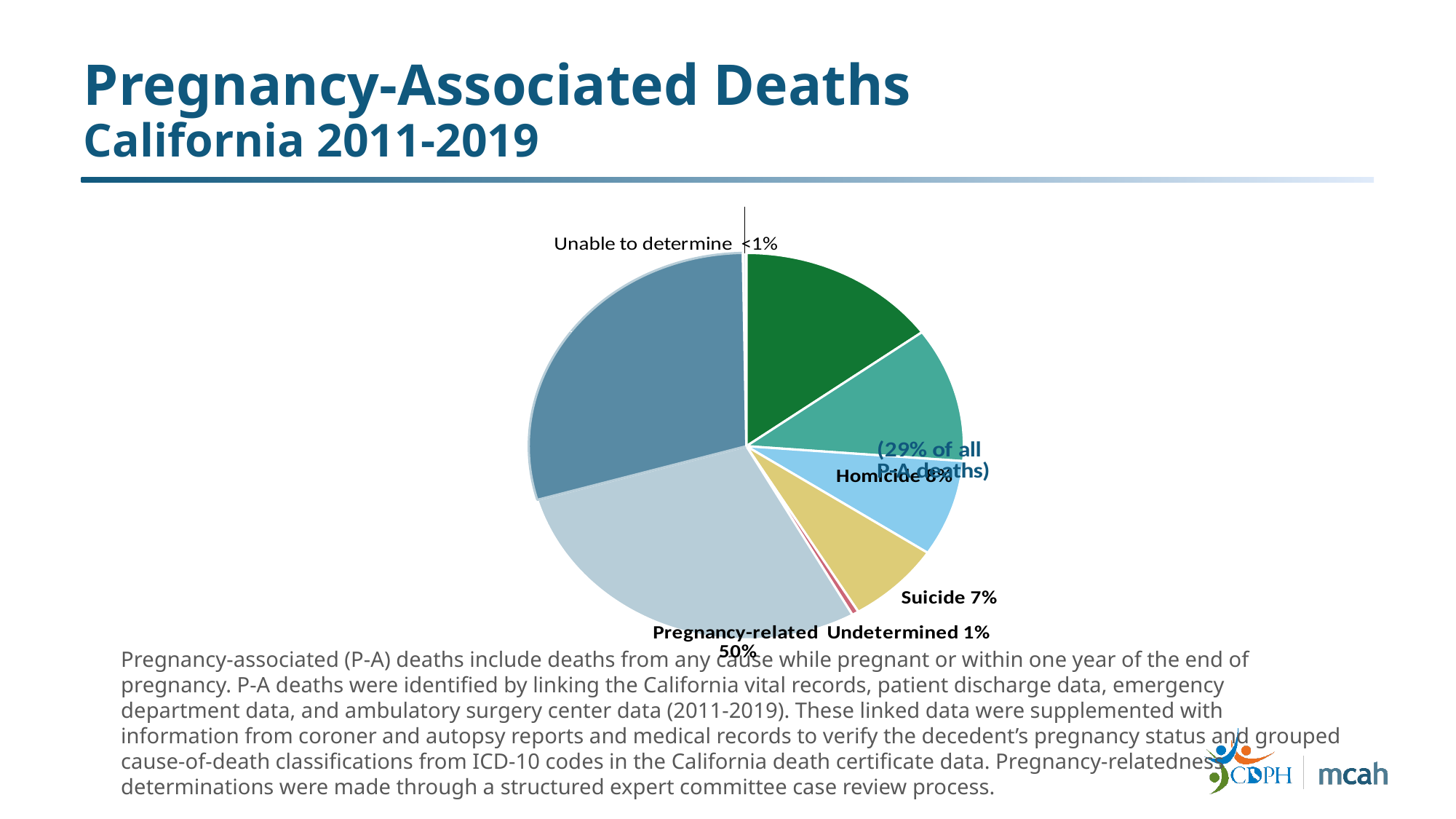
What is the difference in percentage points between Pregnancy-related and Homicide? 42 percentage points What percentage is shown for Undetermined? 1% Which labelled category has the largest slice of the pie? Pregnancy-related What percentage is shown for Homicide? 8% Which labelled category has the smallest slice of the pie? Unable to determine What is the title of the slide containing the pie chart? Pregnancy-Associated Deaths California 2011-2019 What percentage of pregnancy-associated deaths is labelled as Pregnancy-related? 50% Which is larger, the Homicide slice or the Suicide slice? Homicide What value is shown for the Unable to determine slice? <1% What is the difference in percentage points between Homicide and Suicide? 1 percentage point What percentage is shown for Suicide? 7% What kind of chart is shown on the slide? pie chart